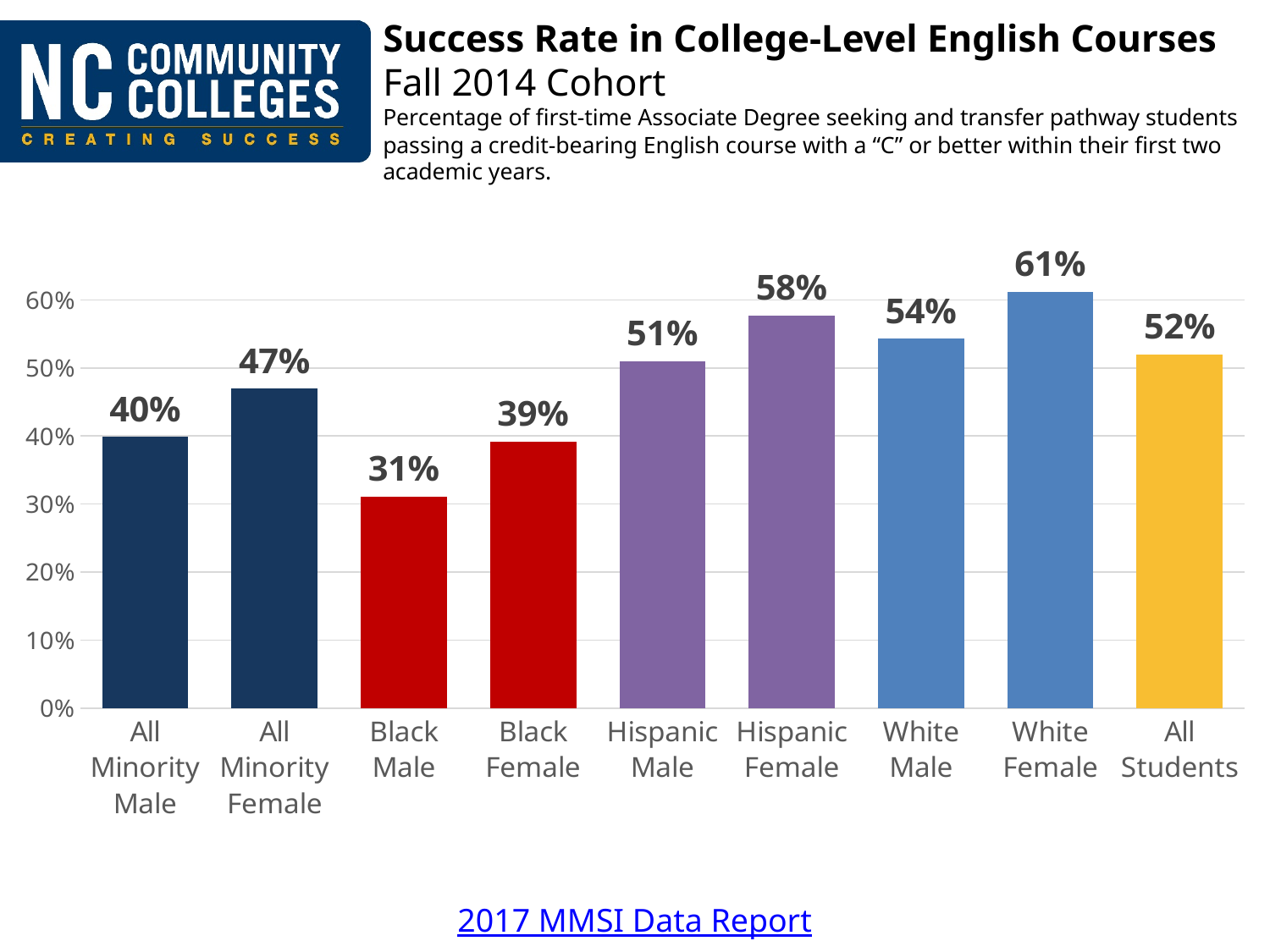
What is the success rate for Hispanic Female students? 58% What is the title of the chart? Success Rate in College-Level English Courses What kind of chart is shown on the slide? Bar chart Is the success rate for Black Female students greater or less than 40%? less What is the difference between the success rates of White Female and Black Male students? 30 percentage points Which category has the lowest success rate? Black Male Which has a higher success rate, Hispanic Male or White Male? White Male Which category has the highest success rate? White Female What is the difference between the success rates of All Minority Female and All Minority Male students? 7 percentage points What is the success rate for All Students? 52% What is the success rate for Black Male students? 31% How many categories are shown on the chart? 9